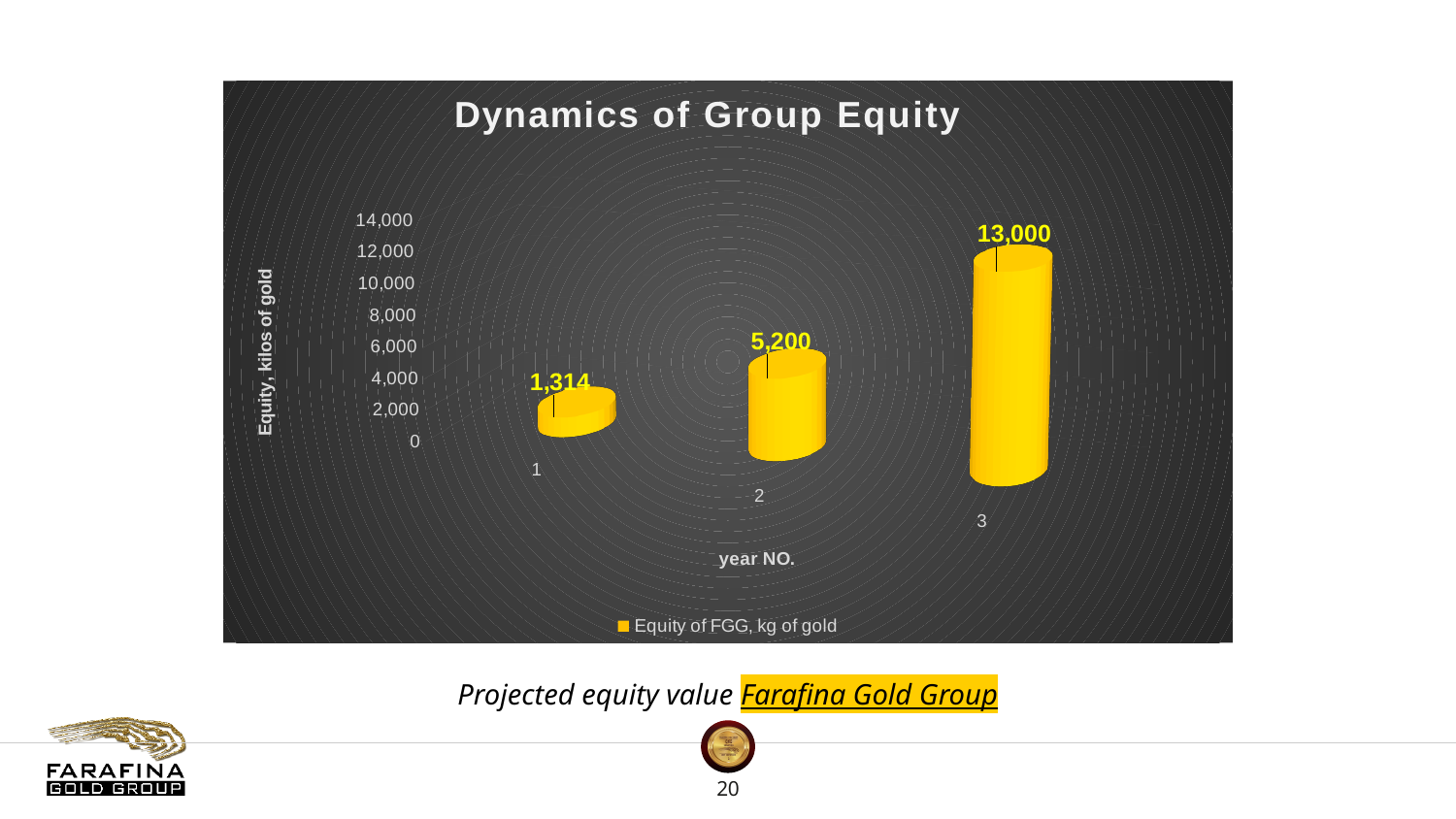
What is the equity value for year 3? 13,000 How many years are plotted on the chart? 3 Which year has the lowest equity value? 1 How many series does the legend list? 1 What is the equity value for year 2? 5,200 What is the difference between the equity values for year 2 and year 1? 3,886 Which year has the highest equity value? 3 What kind of chart is shown? bar chart Do the equity values rise or fall from year 1 to year 3? rise Which is larger, the equity value for year 2 or year 1? year 2 What is the equity value for year 1? 1,314 What is the difference between the equity values for year 3 and year 2? 7,800